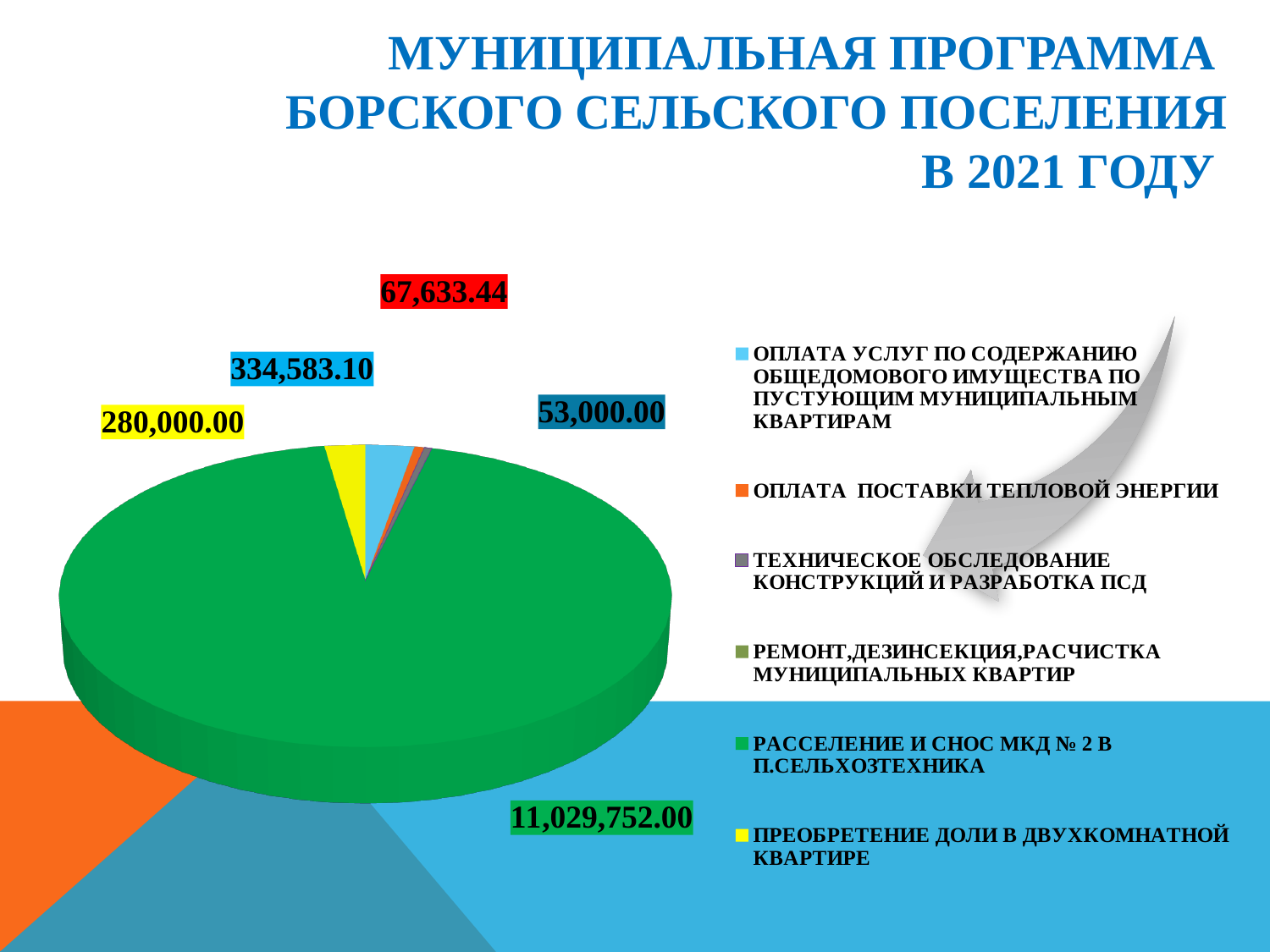
What colour is the slice for РАССЕЛЕНИЕ И СНОС МКД № 2 В П.СЕЛЬХОЗТЕХНИКА? green What is the difference between the value for РАССЕЛЕНИЕ И СНОС МКД № 2 В П.СЕЛЬХОЗТЕХНИКА and the value for ОПЛАТА УСЛУГ ПО СОДЕРЖАНИЮ ОБЩЕДОМОВОГО ИМУЩЕСТВА ПО ПУСТУЮЩИМ МУНИЦИПАЛЬНЫМ КВАРТИРАМ? 10,695,168.90 What is the value for ОПЛАТА УСЛУГ ПО СОДЕРЖАНИЮ ОБЩЕДОМОВОГО ИМУЩЕСТВА ПО ПУСТУЮЩИМ МУНИЦИПАЛЬНЫМ КВАРТИРАМ? 334,583.10 What is the difference between the value for ОПЛАТА УСЛУГ ПО СОДЕРЖАНИЮ ОБЩЕДОМОВОГО ИМУЩЕСТВА ПО ПУСТУЮЩИМ МУНИЦИПАЛЬНЫМ КВАРТИРАМ and the value for ПРЕОБРЕТЕНИЕ ДОЛИ В ДВУХКОМНАТНОЙ КВАРТИРЕ? 54,583.10 What is the smallest value printed as a data label on the chart? 53,000.00 Which category has the largest slice of the pie? РАССЕЛЕНИЕ И СНОС МКД № 2 В П.СЕЛЬХОЗТЕХНИКА What is the value for РАССЕЛЕНИЕ И СНОС МКД № 2 В П.СЕЛЬХОЗТЕХНИКА? 11,029,752.00 What colour is the legend marker for ОПЛАТА ПОСТАВКИ ТЕПЛОВОЙ ЭНЕРГИИ? orange Which is larger: the value for ОПЛАТА УСЛУГ ПО СОДЕРЖАНИЮ ОБЩЕДОМОВОГО ИМУЩЕСТВА ПО ПУСТУЮЩИМ МУНИЦИПАЛЬНЫМ КВАРТИРАМ or the value for ПРЕОБРЕТЕНИЕ ДОЛИ В ДВУХКОМНАТНОЙ КВАРТИРЕ? ОПЛАТА УСЛУГ ПО СОДЕРЖАНИЮ ОБЩЕДОМОВОГО ИМУЩЕСТВА ПО ПУСТУЮЩИМ МУНИЦИПАЛЬНЫМ КВАРТИРАМ How many categories does the legend list? 6 What kind of chart is shown on the slide? pie chart What is the value for ПРЕОБРЕТЕНИЕ ДОЛИ В ДВУХКОМНАТНОЙ КВАРТИРЕ? 280,000.00